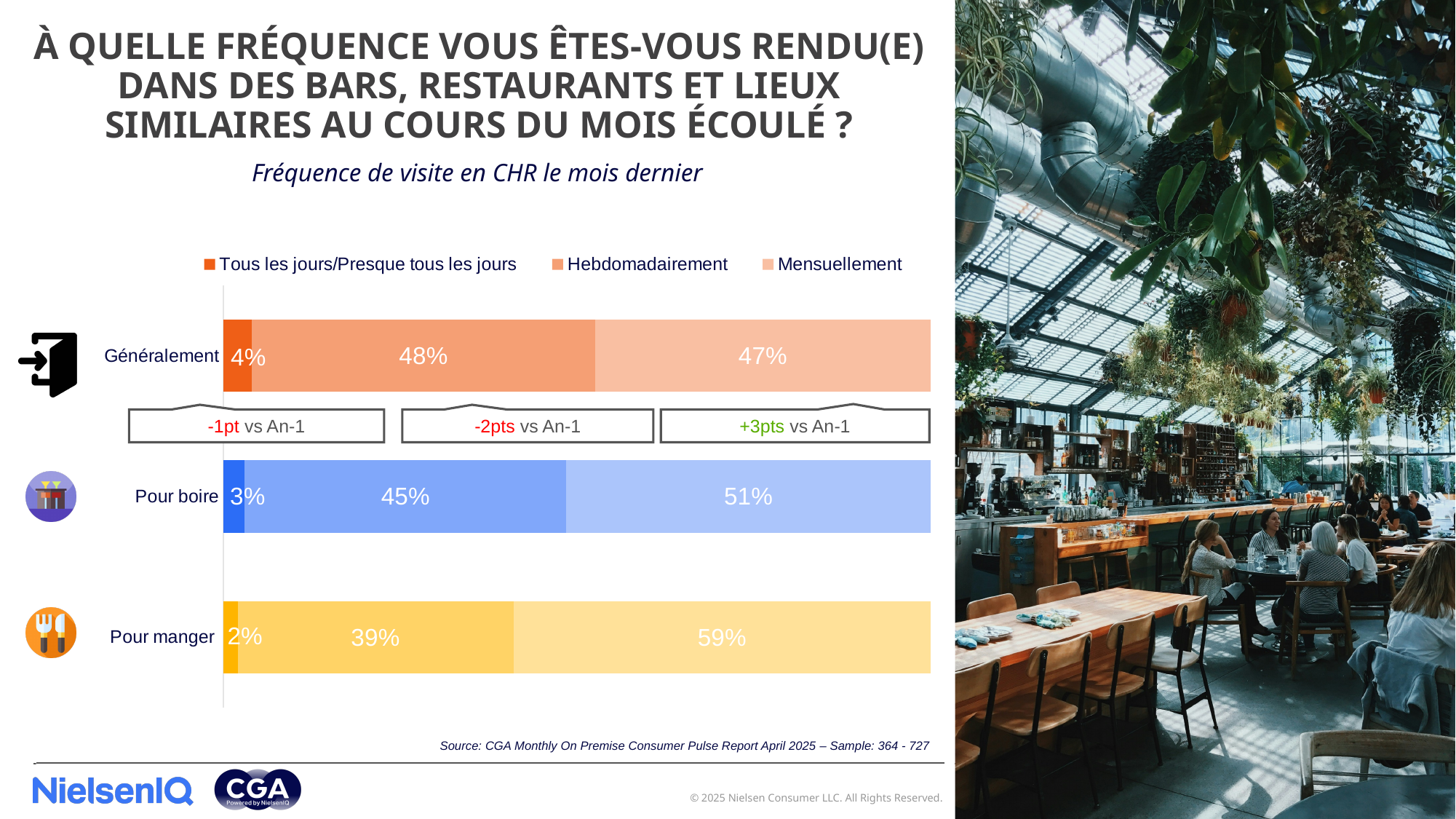
How many categories are shown on the chart? 3 What is the total of the stacked bar for 'Pour boire'? 99% Which category has the highest 'Mensuellement' share? Pour manger Which category has the lowest 'Tous les jours/Presque tous les jours' share? Pour manger How many series does the legend list? 3 What is the difference between the 'Hebdomadairement' values for 'Généralement' and 'Pour manger'? 9 points What is the change vs An-1 shown for the 'Mensuellement' segment of 'Généralement'? +3pts Is the 'Mensuellement' value larger for 'Pour boire' or for 'Généralement'? Pour boire What kind of chart is shown on the slide? Stacked bar chart What percentage of respondents visit 'Généralement' on a weekly basis (Hebdomadairement)? 48% What is the 'Mensuellement' value for 'Pour manger'? 59% What is the 'Tous les jours/Presque tous les jours' value for 'Pour boire'? 3%